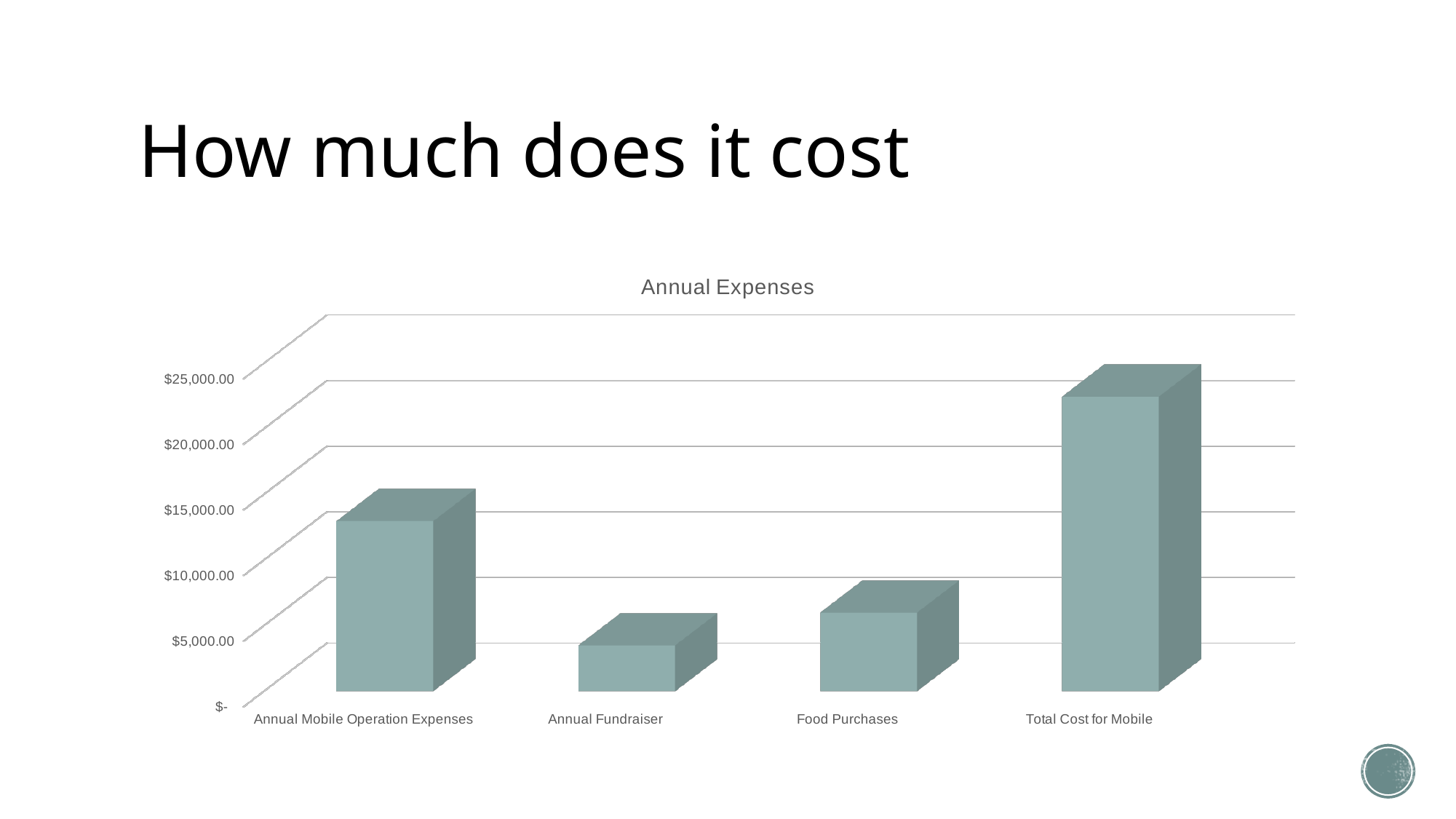
What type of chart is shown on the slide? bar chart How many categories are plotted in the chart? 4 Which is larger, the value for Food Purchases or the value for Annual Fundraiser? Food Purchases Which category has the highest value? Total Cost for Mobile What is the label of the lowest tick on the vertical axis? $- Is the value for Annual Fundraiser greater or less than $10,000.00? less Which category has the lowest value? Annual Fundraiser What is the title of the chart? Annual Expenses Is the value for Food Purchases greater or less than $10,000.00? less Is the value for Total Cost for Mobile greater or less than $20,000.00? greater Which is larger, the value for Annual Mobile Operation Expenses or the value for Food Purchases? Annual Mobile Operation Expenses